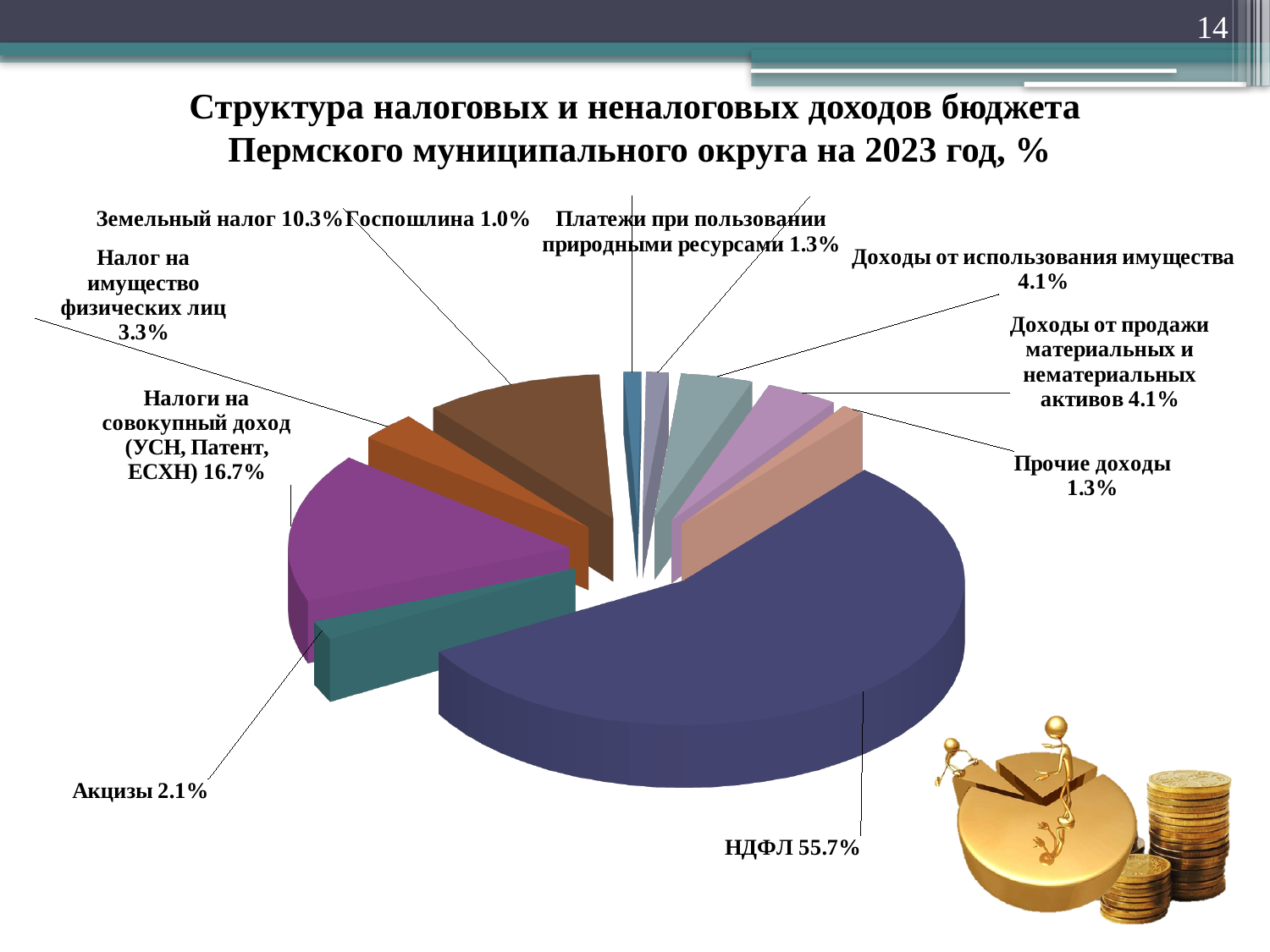
What is the difference in percentage points between НДФЛ and Налоги на совокупный доход (УСН, Патент, ЕСХН)? 39.0 What is the value for Акцизы? 2.1% Which category has the smallest slice of the pie? Госпошлина What is the title of the chart? Структура налоговых и неналоговых доходов бюджета Пермского муниципального округа на 2023 год, % Which is larger: Земельный налог or Налог на имущество физических лиц? Земельный налог What is the combined share of Доходы от использования имущества and Доходы от продажи материальных и нематериальных активов? 8.2% What is the value shown for Налоги на совокупный доход (УСН, Патент, ЕСХН)? 16.7% What percentage is shown for Земельный налог? 10.3% How many categories (slices) are shown in the pie chart? 10 What type of chart is shown on the slide? Pie chart What share of the pie does НДФЛ account for? 55.7% Which category has the largest slice of the pie? НДФЛ